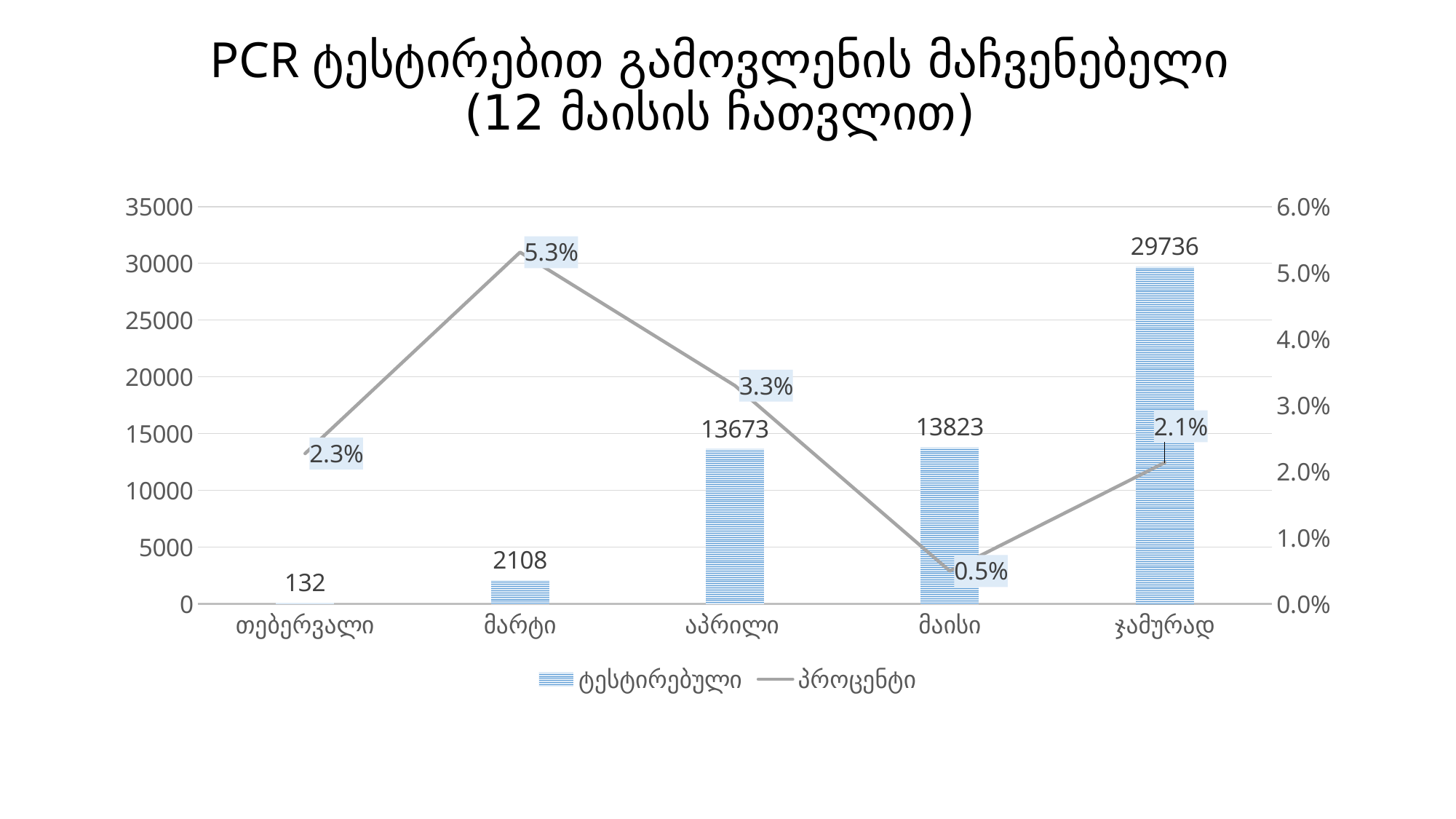
Which series is drawn as a line? პროცენტი What is the value of ტესტირებული for მარტი? 2108 What is the difference between the ტესტირებული values for მაისი and აპრილი? 150 What is the პროცენტი value for მარტი? 5.3% What is the პროცენტი value for მაისი? 0.5% How many series does the legend list? 2 What kind of chart is shown on the slide? Combined bar and line chart Which is larger, the პროცენტი value for თებერვალი or for ჯამურად? თებერვალი How many categories are shown on the x axis? 5 Which category has the highest ტესტირებული value? ჯამურად Which category has the lowest პროცენტი value? მაისი What is the value of ტესტირებული for აპრილი? 13673